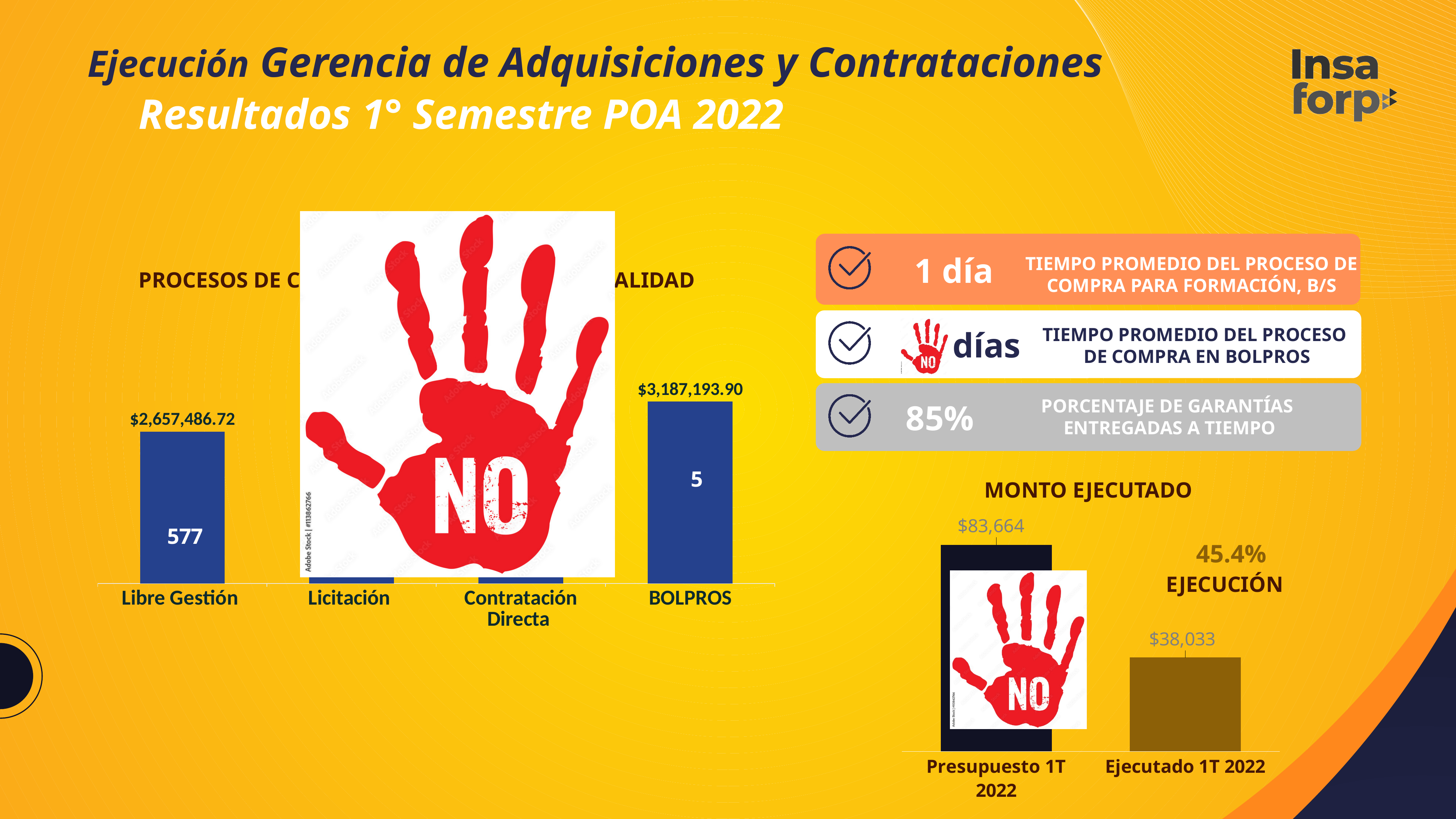
In the chart on the left, what number is printed inside the BOLPROS bar? 5 In the chart on the left, which has the larger amount, Libre Gestión or BOLPROS? BOLPROS In the MONTO EJECUTADO chart, what is the value for Presupuesto 1T 2022? $83,664 In the chart on the left, what number is printed inside the Libre Gestión bar? 577 In the MONTO EJECUTADO chart, what is the difference between Presupuesto 1T 2022 and Ejecutado 1T 2022? $45,631 In the MONTO EJECUTADO chart, what is the value for Ejecutado 1T 2022? $38,033 In the chart on the left, what is the value labelled for BOLPROS? $3,187,193.90 In the chart on the left, what is the difference between the BOLPROS amount and the Libre Gestión amount? $529,707.18 In the MONTO EJECUTADO chart, what execution percentage is printed next to the bars? 45.4% How many categories are shown on the x axis of the chart on the left? 4 In the chart on the left, what is the value labelled for Libre Gestión? $2,657,486.72 What kind of chart is the MONTO EJECUTADO chart? bar chart